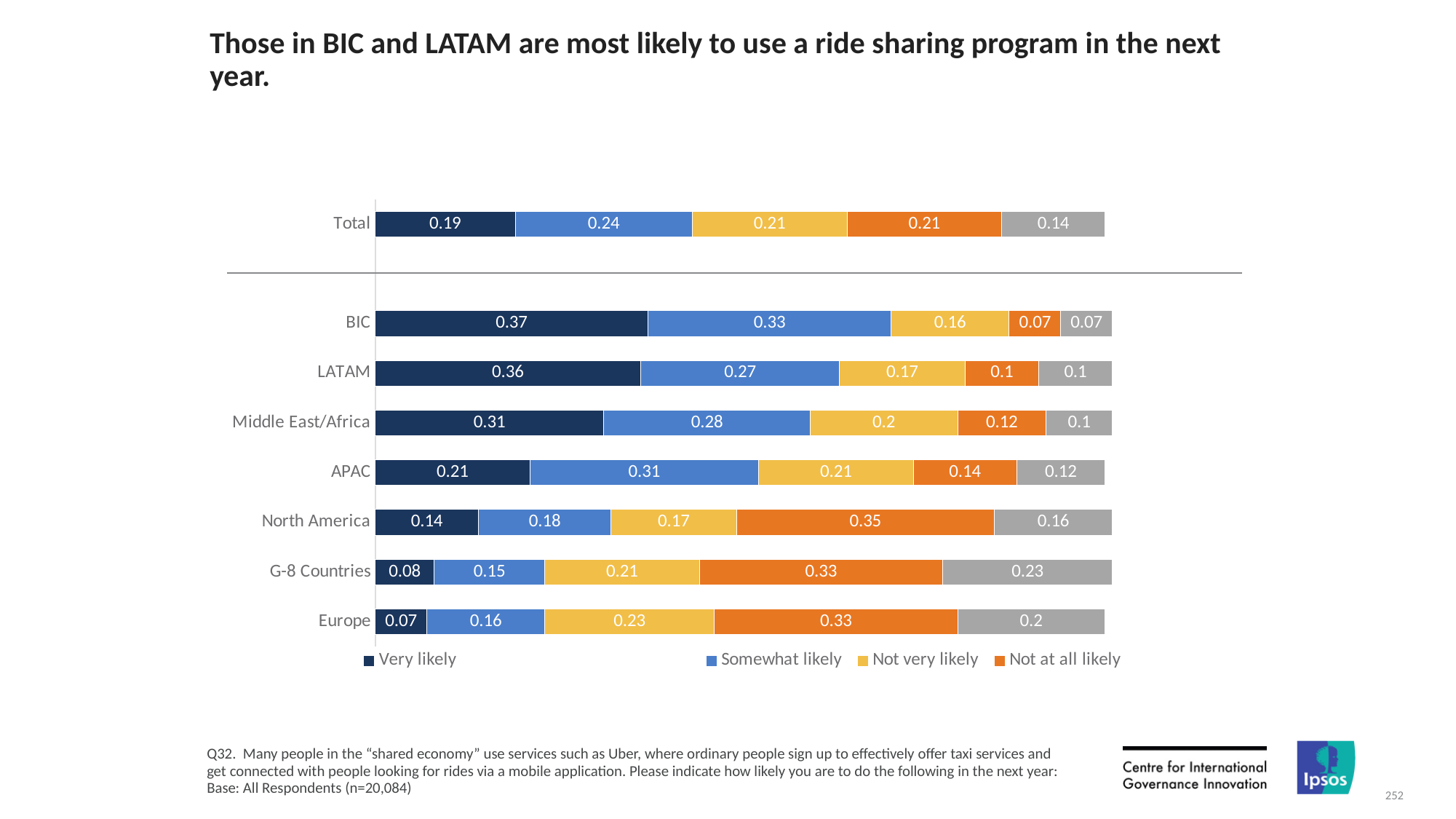
What is the 'Not at all likely' value for North America? 0.35 How many series does the legend list? 4 What is the difference between the 'Very likely' values for BIC and Europe? 0.3 What is the sum of all five segments of the BIC bar? 1 What is the 'Somewhat likely' value for APAC? 0.31 Which region has the highest 'Very likely' value? BIC Which region has the lowest 'Very likely' value? Europe How many regions (including Total) are shown on the chart? 8 Which has the larger 'Somewhat likely' value, BIC or LATAM? BIC What is the 'Very likely' value for BIC? 0.37 What is the 'Not very likely' value for Europe? 0.23 What kind of chart is shown on the slide? Stacked bar chart